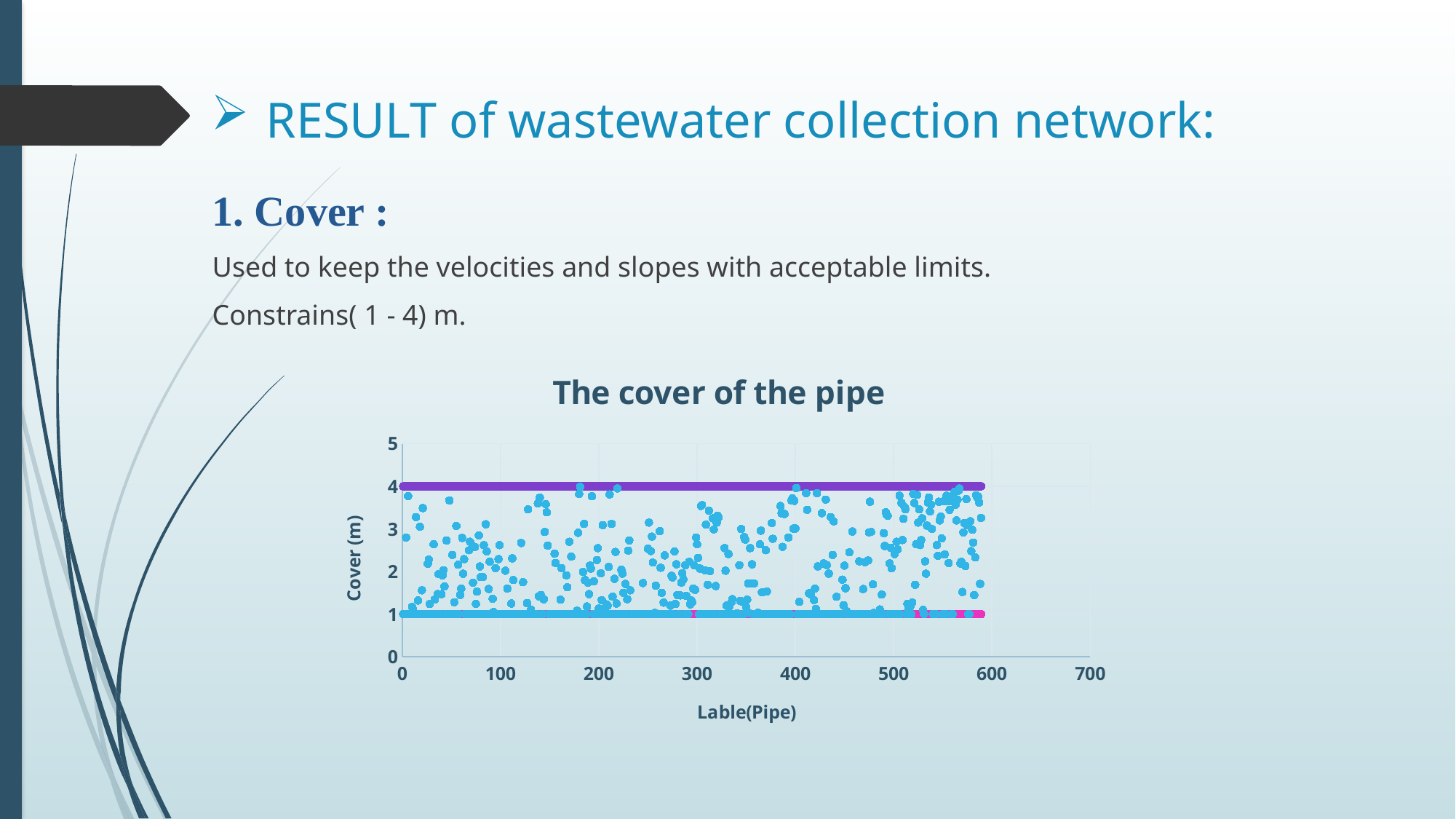
Is the purple horizontal line at a greater or lower value than the blue horizontal line? greater At what value on the Cover (m) axis does the lower blue horizontal line sit? 1 Are the scattered data points plotted above or below the Cover (m) value of 5? below What is the highest tick value shown on the Cover (m) axis? 5 At what value on the Cover (m) axis does the purple horizontal line sit? 4 What is the title of the chart? The cover of the pipe What is the highest tick value shown on the Lable(Pipe) axis? 700 Do the scattered data points extend beyond a Lable(Pipe) value of 600? No What is the difference in Cover (m) between the purple horizontal line and the blue horizontal line? 3 What kind of chart is shown on the slide? scatter chart What is the label of the vertical axis of the chart? Cover (m)